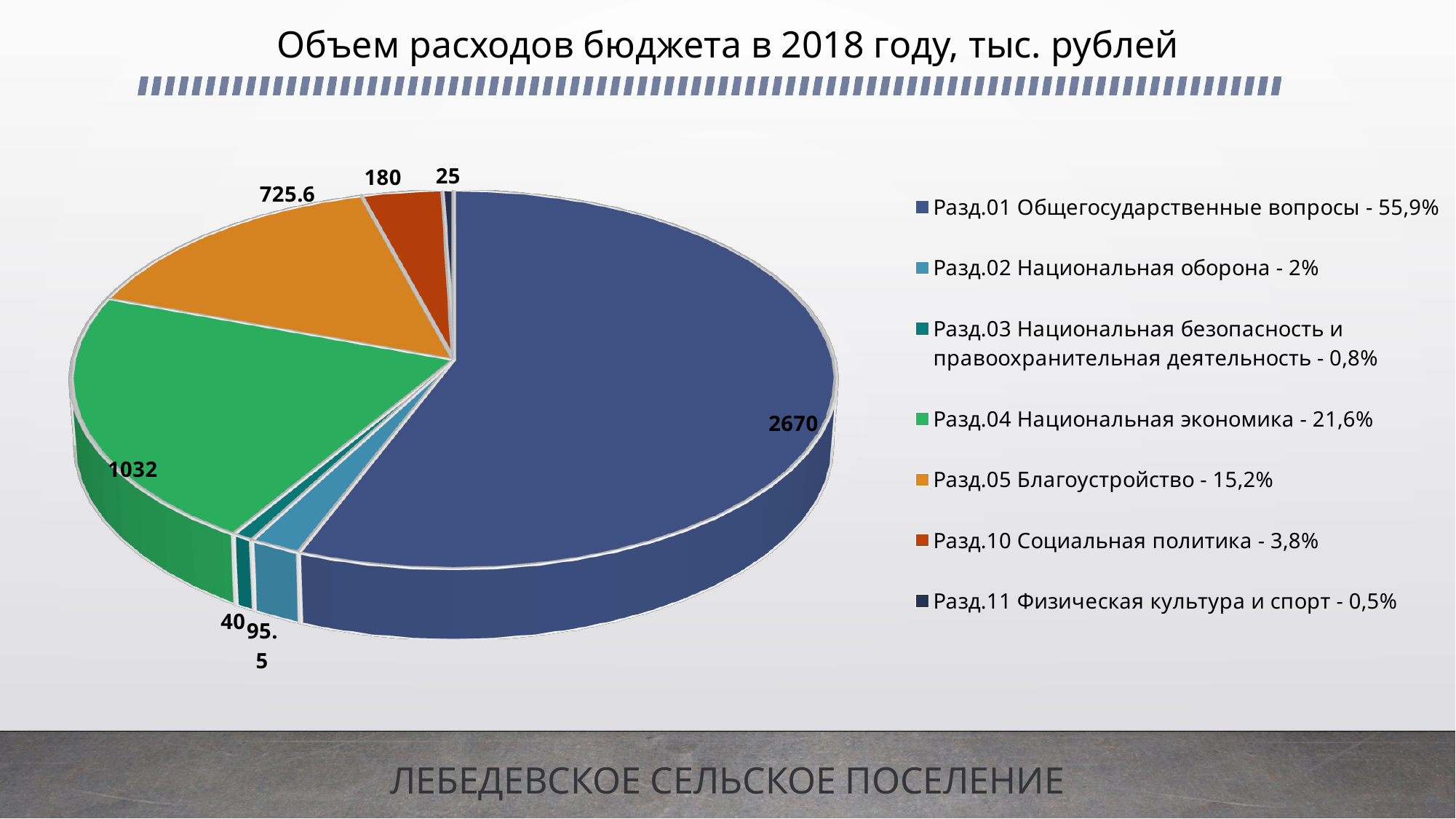
What share of the budget does Разд.05 Благоустройство account for, according to the legend? 15,2% What is the value for Разд.01 Общегосударственные вопросы? 2670 What kind of chart is shown on the slide? pie chart What is the difference between the values for Разд.04 Национальная экономика and Разд.05 Благоустройство? 306.4 What is the value for Разд.05 Благоустройство? 725.6 Which section has the largest share of the budget expenditure? Разд.01 Общегосударственные вопросы What is the value for Разд.02 Национальная оборона? 95.5 Which section has the smallest value? Разд.11 Физическая культура и спорт Which is larger, the value for Разд.10 Социальная политика or Разд.02 Национальная оборона? Разд.10 Социальная политика How many sections (slices) does the pie chart show? 7 What is the value for Разд.04 Национальная экономика? 1032 What is the value for Разд.10 Социальная политика? 180